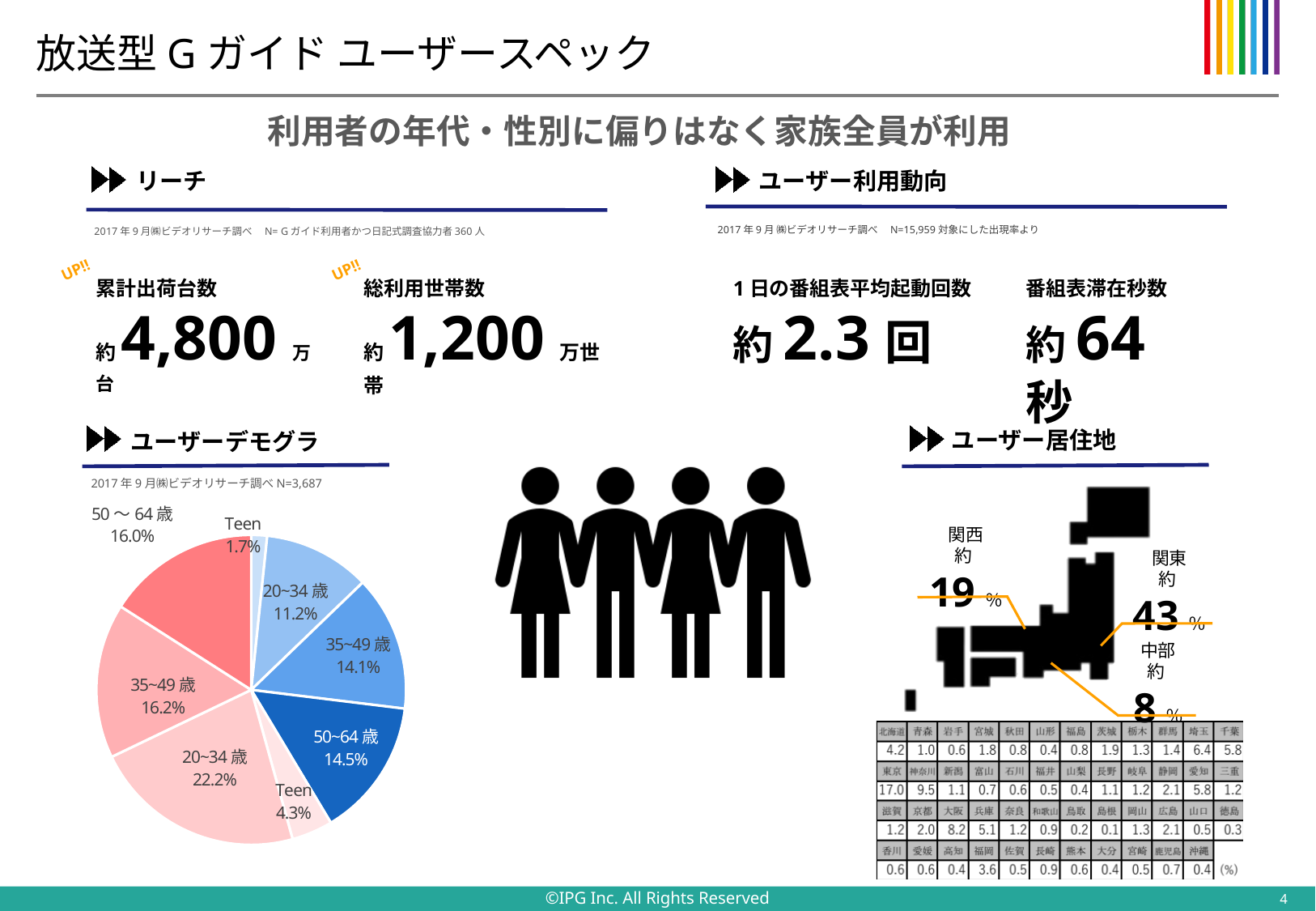
In the ユーザーデモグラ pie chart, what is the value of the dark blue 50~64歳 slice? 14.5% In the ユーザーデモグラ pie chart, which is larger: the blue 35~49歳 slice or the pink 35~49歳 slice? The pink 35~49歳 slice (16.2%) What kind of chart is shown in the ユーザーデモグラ section? Pie chart In the ユーザーデモグラ pie chart, what is the value of the red 50～64歳 slice? 16.0% What is the sample size (N) stated above the ユーザーデモグラ pie chart? N=3,687 Which slice is the largest in the ユーザーデモグラ pie chart? 20~34歳 (pink), 22.2% How many slices does the ユーザーデモグラ pie chart have? 8 In the ユーザーデモグラ pie chart, what is the value of the light blue Teen slice? 1.7% Which slice is the smallest in the ユーザーデモグラ pie chart? Teen (light blue), 1.7% In the ユーザーデモグラ pie chart, what is the difference between the pink 20~34歳 slice and the blue 20~34歳 slice? 11.0 percentage points In the ユーザーデモグラ pie chart, what is the difference between the pink Teen slice and the blue Teen slice? 2.6 percentage points In the ユーザーデモグラ pie chart, what is the value of the pink 20~34歳 slice? 22.2%